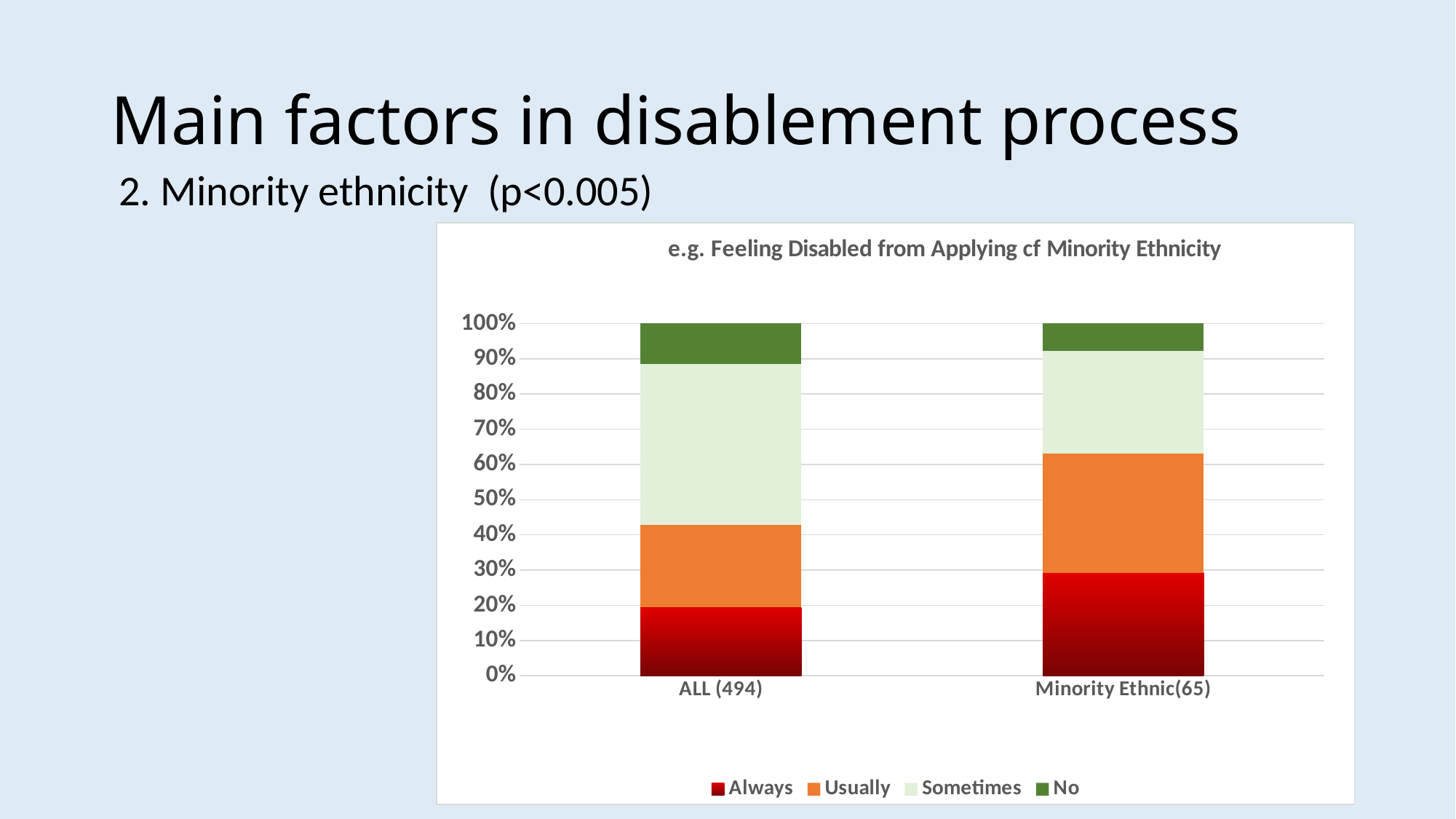
Is the combined 'Always' and 'Usually' share for ALL (494) greater or less than 50%? less What is the title of the chart? e.g. Feeling Disabled from Applying cf Minority Ethnicity Which series is shown in dark green in the chart? No Is the 'Always' share for Minority Ethnic(65) greater or less than 20%? greater Is the combined 'Always' and 'Usually' share for Minority Ethnic(65) greater or less than 50%? greater How many series does the chart's legend list? 4 How many categories are shown on the x axis of the chart? 2 Which category has the larger 'Sometimes' segment, ALL (494) or Minority Ethnic(65)? ALL (494) Which category has the larger 'Always' segment, ALL (494) or Minority Ethnic(65)? Minority Ethnic(65) Which category has the larger 'No' segment, ALL (494) or Minority Ethnic(65)? ALL (494) What kind of chart is shown on the slide? stacked bar chart